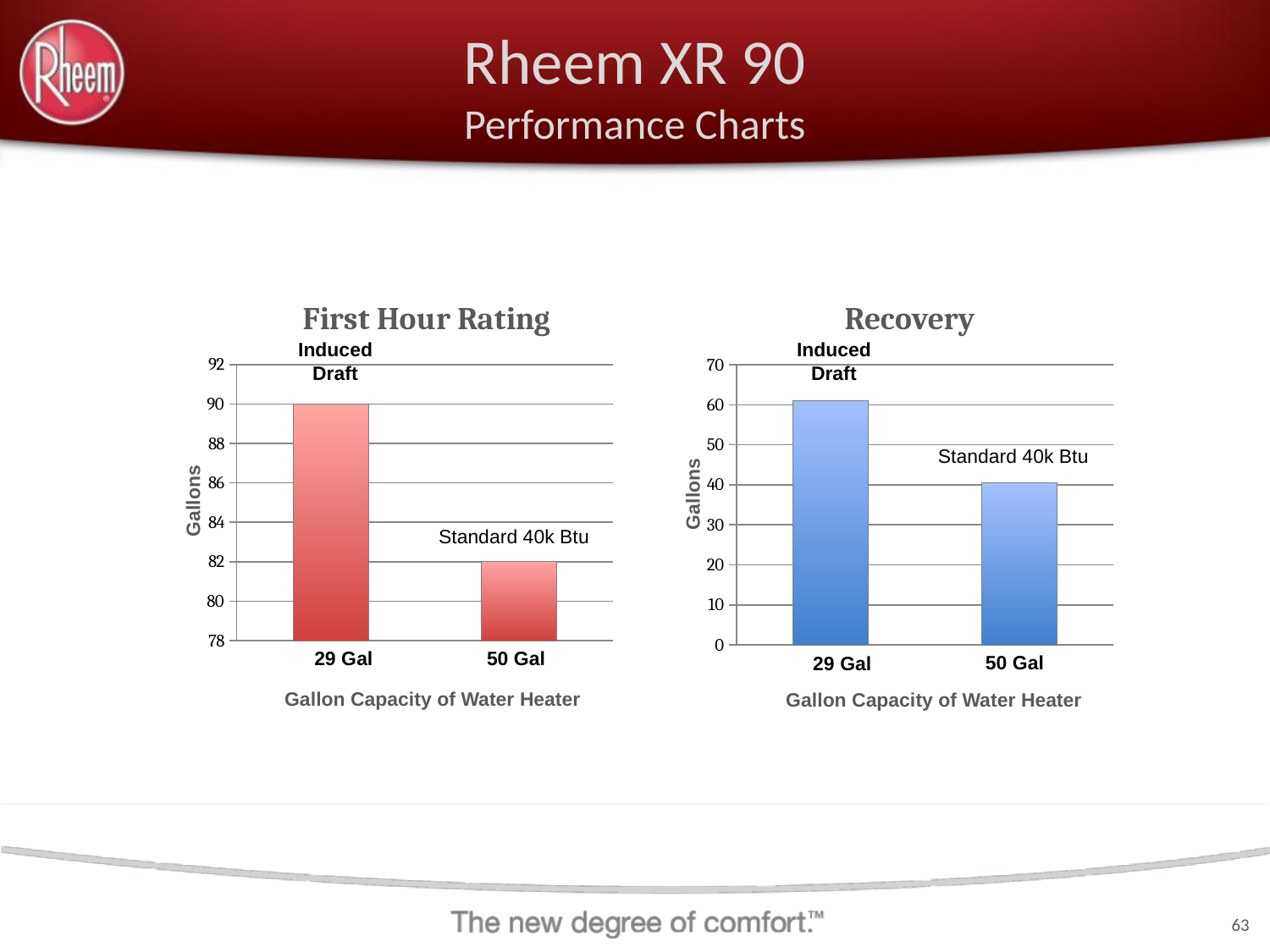
In the Recovery chart, is the value for 29 Gal larger or smaller than the value for 50 Gal? larger What kind of chart is the First Hour Rating chart? bar chart In the Recovery chart, is the value for 29 Gal greater or less than 60? greater In the Recovery chart, which gallon capacity has the lower value? 50 Gal In the First Hour Rating chart, which gallon capacity has the higher value? 29 Gal In the First Hour Rating chart, what is the value for 29 Gal? 90 In the First Hour Rating chart, what is the difference between the 29 Gal and 50 Gal values? 8 What is the x-axis title of the First Hour Rating chart? Gallon Capacity of Water Heater How many categories are shown on the x axis of the Recovery chart? 2 In the Recovery chart, is the value for 50 Gal greater or less than 50? less What is the y-axis label of the Recovery chart? Gallons In the First Hour Rating chart, what is the value for 50 Gal? 82